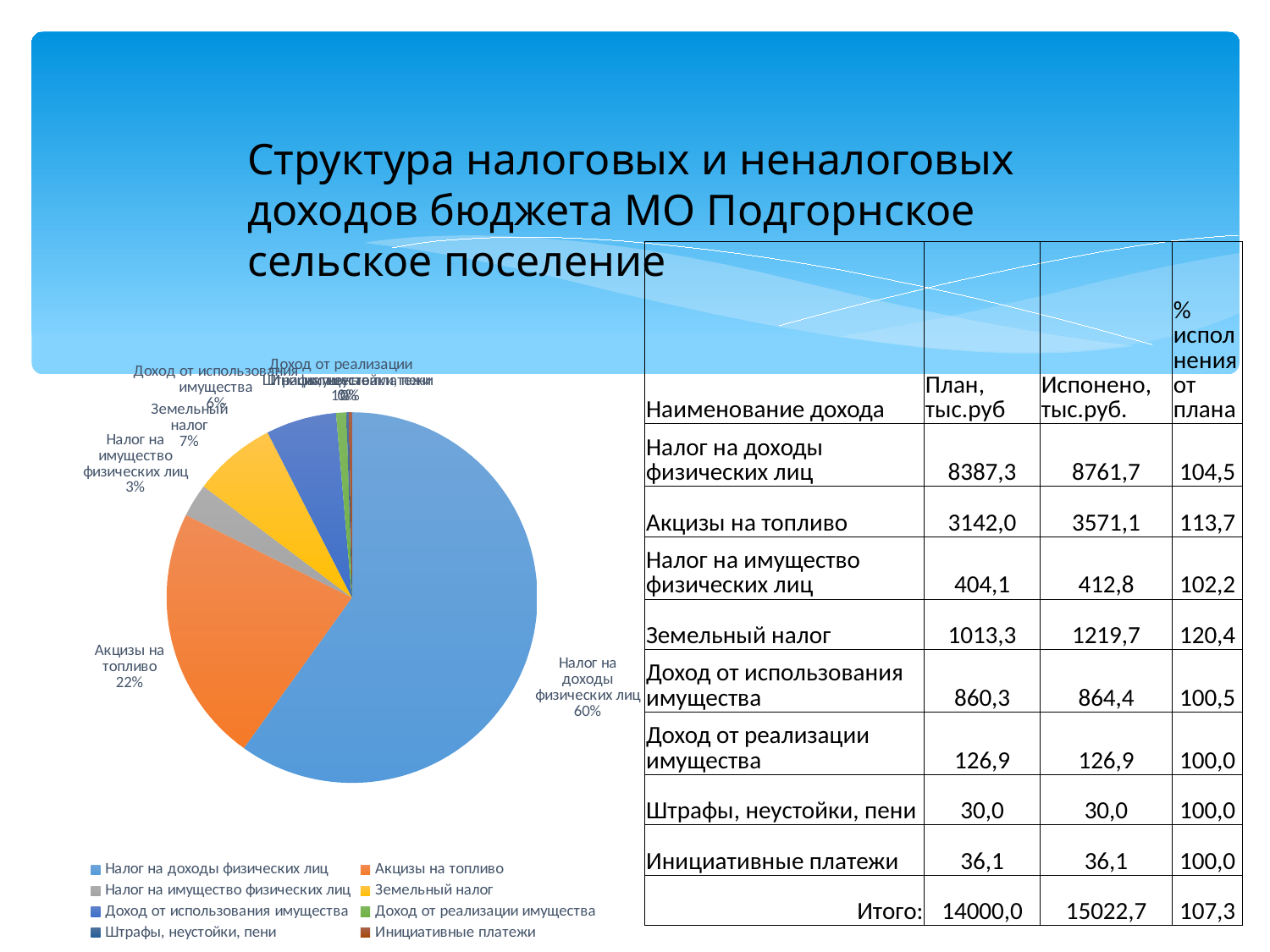
What is the difference in percentage points between "Земельный налог" and "Налог на имущество физических лиц" in the pie chart? 4 What is the difference in percentage points between "Налог на доходы физических лиц" and "Акцизы на топливо" in the pie chart? 38 What kind of chart is shown on the slide? pie chart What share of the pie does "Налог на доходы физических лиц" represent? 60% What percentage is shown for "Налог на имущество физических лиц" in the pie chart? 3% How many entries does the legend of the pie chart list? 8 Which is larger in the pie chart: "Акцизы на топливо" or "Земельный налог"? Акцизы на топливо What share of the pie does "Акцизы на топливо" represent? 22% What colour is the slice for "Акцизы на топливо" in the pie chart? orange Which category has the largest slice in the pie chart? Налог на доходы физических лиц What percentage is shown for "Доход от использования имущества" in the pie chart? 6% What percentage is shown for "Земельный налог" in the pie chart? 7%